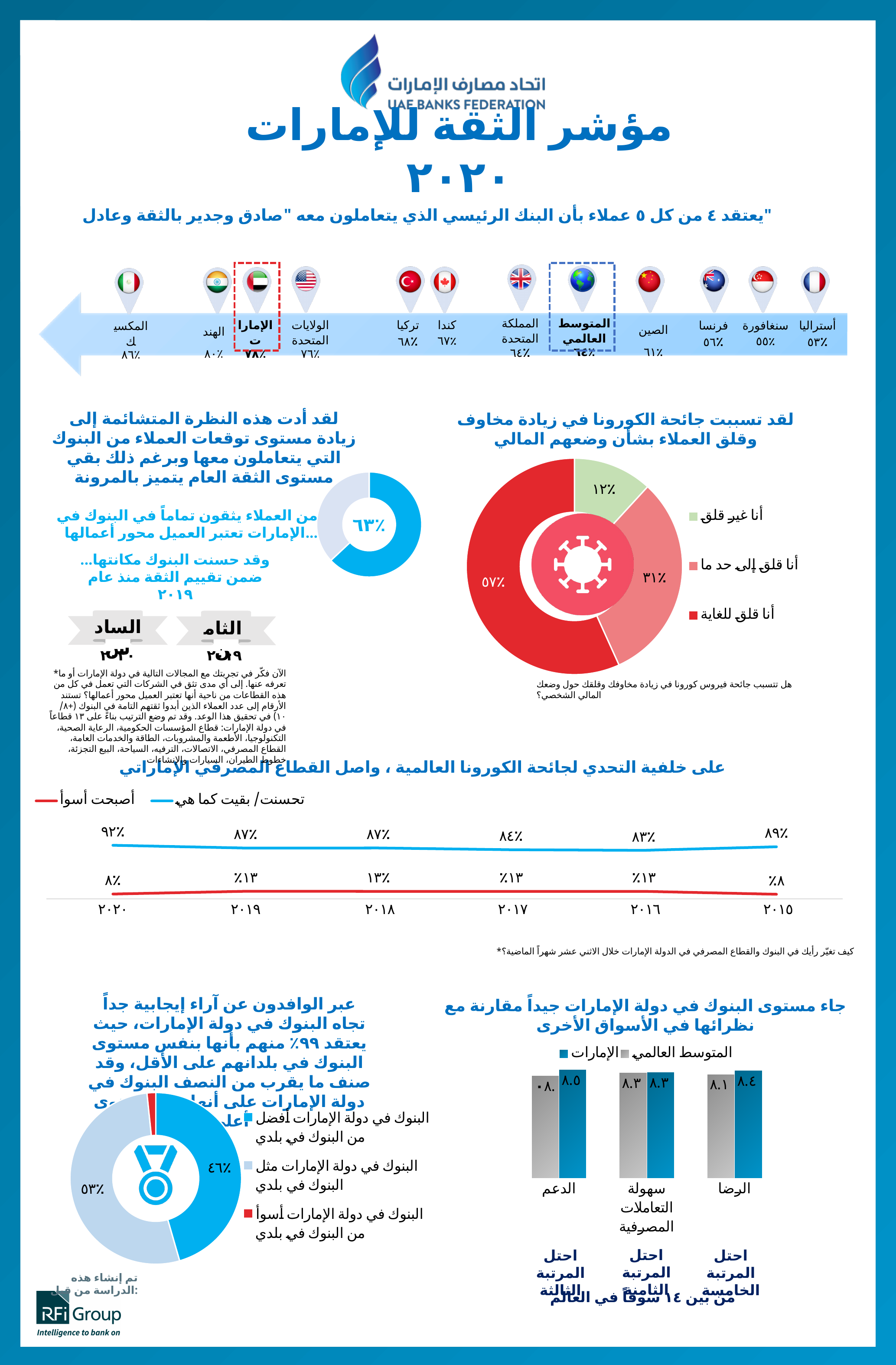
In the donut chart about the coronavirus pandemic (right, middle of the slide), which category has the smallest share? أنا غير قلق In the bar chart at the bottom right of the slide, what is the value for الإمارات in the category الدعم? ٨.٥ In the line chart in the middle of the slide, how many series does the legend list? 2 In the line chart in the middle of the slide, what is the value of the "تحسنت/ بقيت كما هي" line for ٢٠٢٠? ٩٢٪ In the donut chart about the coronavirus pandemic (right, middle of the slide), which category has the largest share? أنا قلق للغاية In the donut chart about the coronavirus pandemic (right, middle of the slide), what share is shown for "أنا قلق للغاية"? ٥٧٪ In the donut chart at the bottom left of the slide, what share is shown for "البنوك في دولة الإمارات مثل البنوك في بلدي"? ٥٣٪ In the donut chart about the coronavirus pandemic (right, middle of the slide), how many categories does the legend list? 3 In the bar chart at the bottom right of the slide, which series has the larger value in the category الدعم, الإمارات or المتوسط العالمي? الإمارات What kind of chart is the chart in the middle of the slide with the years ٢٠١٥ to ٢٠٢٠ on the x axis? line chart In the bar chart at the bottom right of the slide, what is the value for المتوسط العالمي in the category الرضا? ٨.١ In the line chart in the middle of the slide, what is the value of the "أصبحت أسوأ" line for ٢٠١٦? ١٣٪